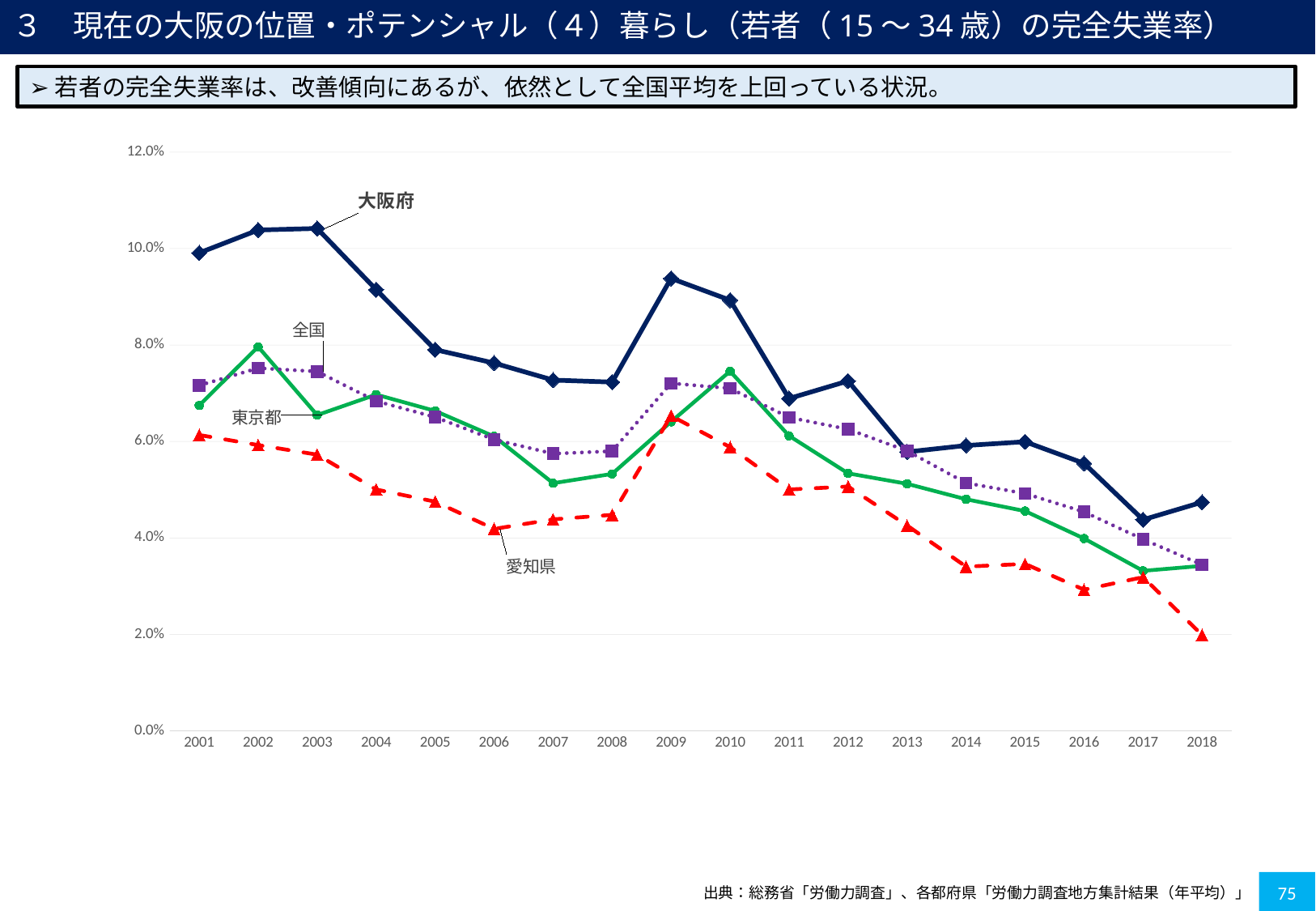
How many series are plotted on the chart? 4 Is the value for 大阪府 in 2001 greater or less than 8.0%? greater Which series has the lowest value in 2018? 愛知県 What kind of chart is shown on the slide? line chart Is the value for 愛知県 in 2018 greater or less than 4.0%? less Does the 大阪府 series generally rise or fall from 2001 to 2018? fall Is the value for 大阪府 in 2009 greater or less than 8.0%? greater Which series has the highest value in 2001? 大阪府 Which series is drawn as a red dashed line with triangle markers? 愛知県 In which year does the 大阪府 series reach its lowest value? 2017 In 2001, which is larger: the value for 大阪府 or the value for 愛知県? 大阪府 How many years are shown on the x axis of the chart? 18